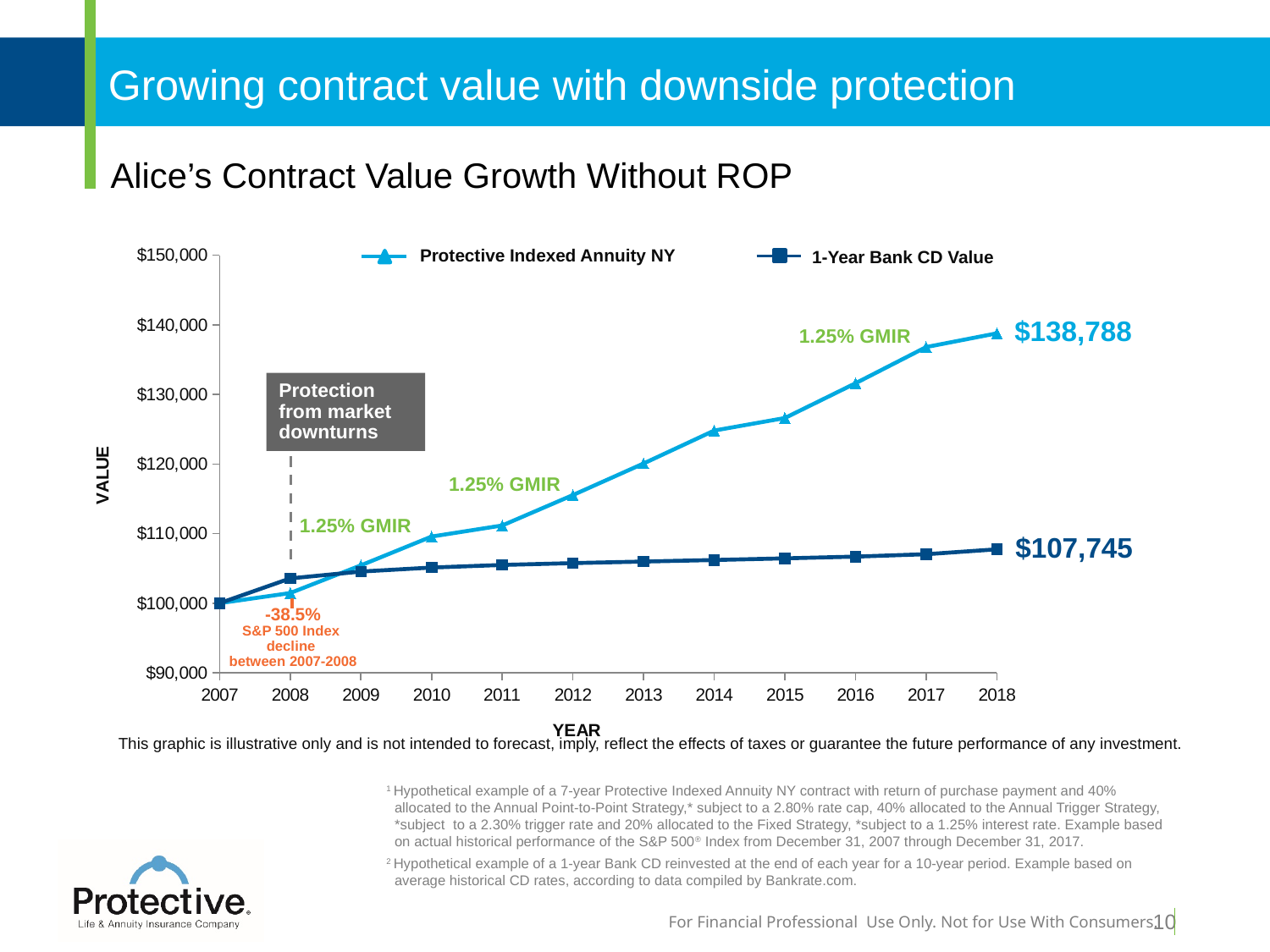
How many series does the chart legend list? 2 What kind of chart is shown on the slide? Line chart In 2018, which is larger: the Protective Indexed Annuity NY value or the 1-Year Bank CD Value? Protective Indexed Annuity NY Is the Protective Indexed Annuity NY value in 2014 greater or less than $120,000? greater Is the Protective Indexed Annuity NY value in 2016 greater or less than $130,000? greater What is the 1-Year Bank CD Value in 2018? $107,745 Does the 1-Year Bank CD Value rise or fall from 2007 to 2018? Rise What is the starting value of both series in 2007? $100,000 Is the 1-Year Bank CD Value in 2012 greater or less than $110,000? less How many years are shown on the x axis of the chart? 12 What is the difference between the Protective Indexed Annuity NY value and the 1-Year Bank CD Value in 2018? $31,043 What is the value of the Protective Indexed Annuity NY in 2018? $138,788